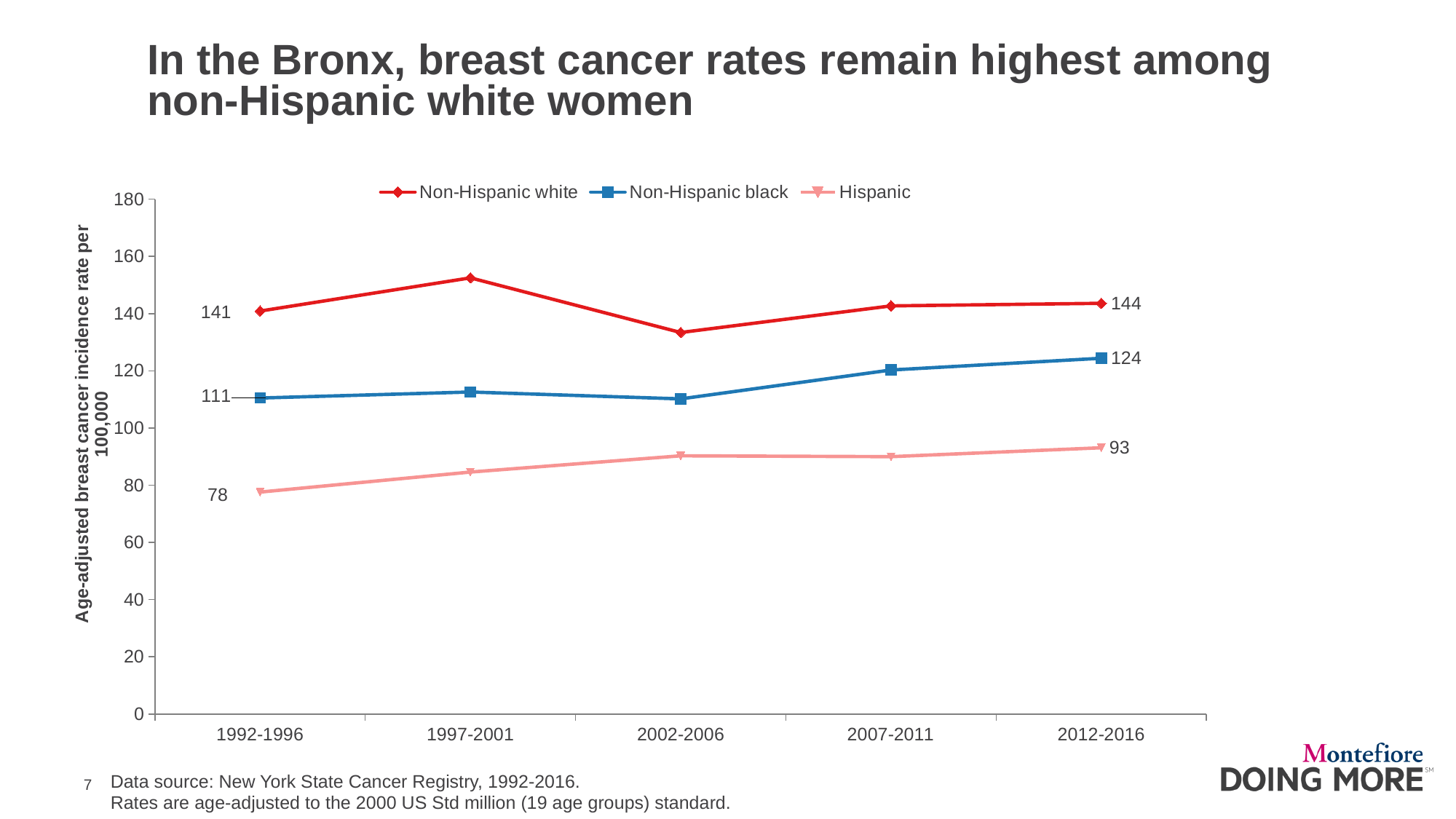
Is the incidence rate for Hispanic women in 2002-2006 greater or less than 100? less By how much did the incidence rate for Non-Hispanic black women increase from 1992-1996 to 2012-2016? 13 Is the incidence rate for Non-Hispanic white women in 1997-2001 greater or less than 140? greater How many time periods are shown on the x axis? 5 What kind of chart is shown on the slide? Line chart Which group has the highest breast cancer incidence rate in 2012-2016? Non-Hispanic white How many series does the legend list? 3 Which group has the lowest breast cancer incidence rate in 1992-1996? Hispanic What is the breast cancer incidence rate for Non-Hispanic white women in 2012-2016? 144 What is the breast cancer incidence rate for Non-Hispanic black women in 2012-2016? 124 What is the difference between the Non-Hispanic white and Hispanic incidence rates in 2012-2016? 51 What is the breast cancer incidence rate for Hispanic women in 1992-1996? 78